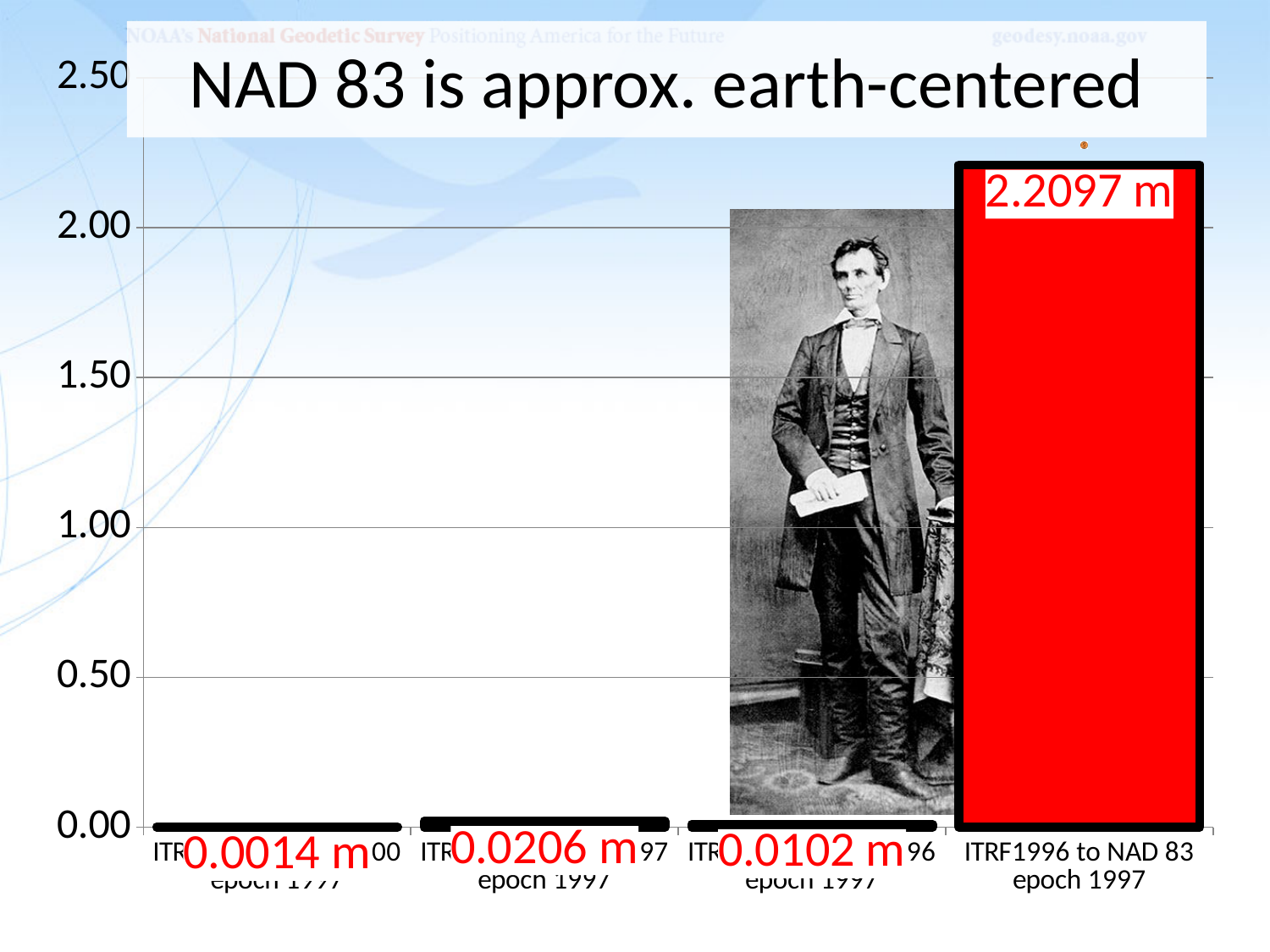
What is the difference between the value for ITRF1996 to NAD 83 epoch 1997 and the value of the second bar from the left (0.0206 m)? 2.1891 m What is the value of the bar labelled "ITRF1996 to NAD 83 epoch 1997"? 2.2097 m What kind of chart is shown on the slide? Bar chart What value is printed on the second bar from the left? 0.0206 m What value is printed on the leftmost bar of the chart? 0.0014 m What value is printed on the third bar from the left? 0.0102 m Is the value for ITRF1996 to NAD 83 epoch 1997 greater or less than 2.00? greater What is the difference between the values of the second bar (0.0206 m) and the third bar (0.0102 m) from the left? 0.0104 m How many bars are plotted in the chart? 4 Which category has the highest value in the chart? ITRF1996 to NAD 83 epoch 1997 Which is larger: the value of the second bar from the left or the value of the third bar from the left? The second bar (0.0206 m) Which bar has the lowest value in the chart? The leftmost bar (0.0014 m)